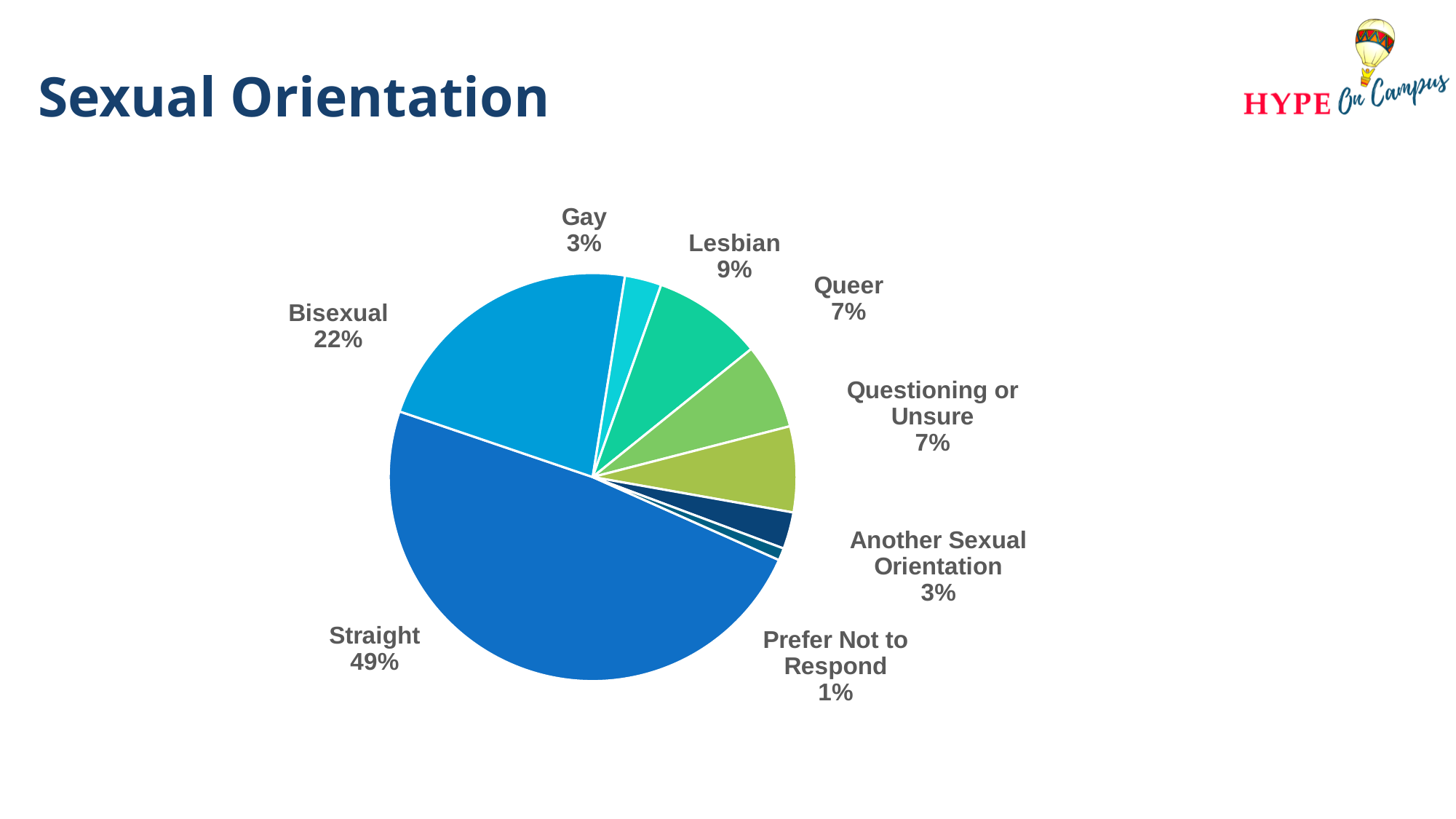
What percentage of respondents chose Prefer Not to Respond? 1% What is the combined share of Gay and Another Sexual Orientation? 6% What is the title of the slide? Sexual Orientation What kind of chart is shown on the slide? pie chart How many categories are shown in the pie chart? 8 What percentage of respondents identified as Bisexual? 22% Which category has the largest share of the pie? Straight What is the difference in percentage points between Straight and Bisexual? 27 Which is larger, the share for Lesbian or the share for Queer? Lesbian Which category has the smallest share of the pie? Prefer Not to Respond What percentage of respondents selected Questioning or Unsure? 7% What percentage of respondents identified as Lesbian? 9%